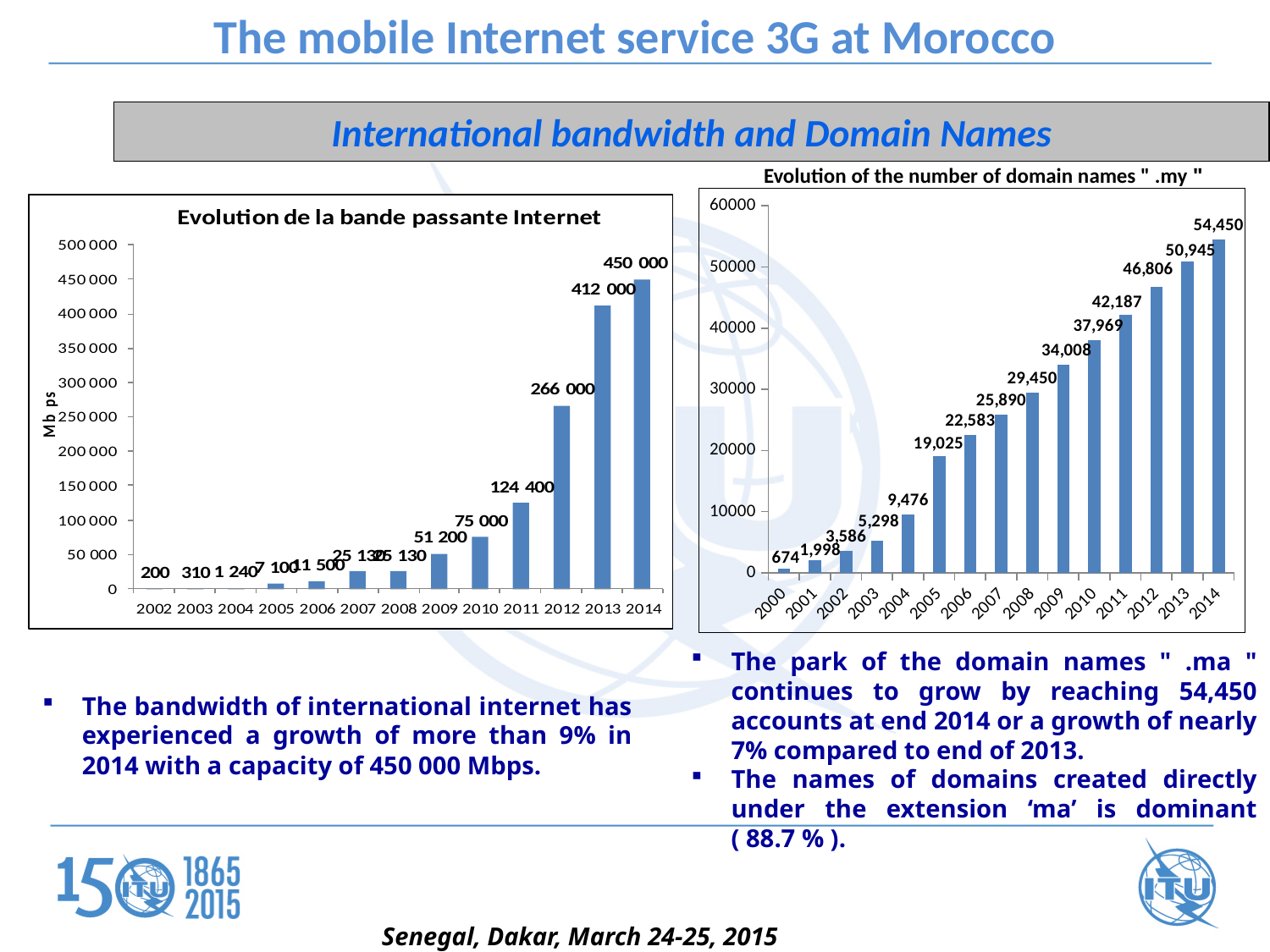
In the left chart 'Evolution de la bande passante Internet', how many years are shown on the x axis? 13 In the right chart 'Evolution of the number of domain names ".my"', what is the value for 2005? 19,025 In the right chart 'Evolution of the number of domain names ".my"', is the value for 2009 greater or less than 30000? greater In the left chart 'Evolution de la bande passante Internet', what is the value for 2014? 450 000 In the right chart 'Evolution of the number of domain names ".my"', which year has the highest value? 2014 In the left chart 'Evolution de la bande passante Internet', which year has the lowest value? 2002 In the left chart 'Evolution de la bande passante Internet', what is the difference between the 2013 and 2012 values? 146 000 In the left chart 'Evolution de la bande passante Internet', do the values rise or fall from 2002 to 2014? rise In the right chart 'Evolution of the number of domain names ".my"', what is the difference between the 2014 and 2013 values? 3,505 What kind of chart is the right chart 'Evolution of the number of domain names ".my"'? bar chart In the left chart 'Evolution de la bande passante Internet', what is the value for 2011? 124 400 In the right chart 'Evolution of the number of domain names ".my"', what is the value for 2014? 54,450